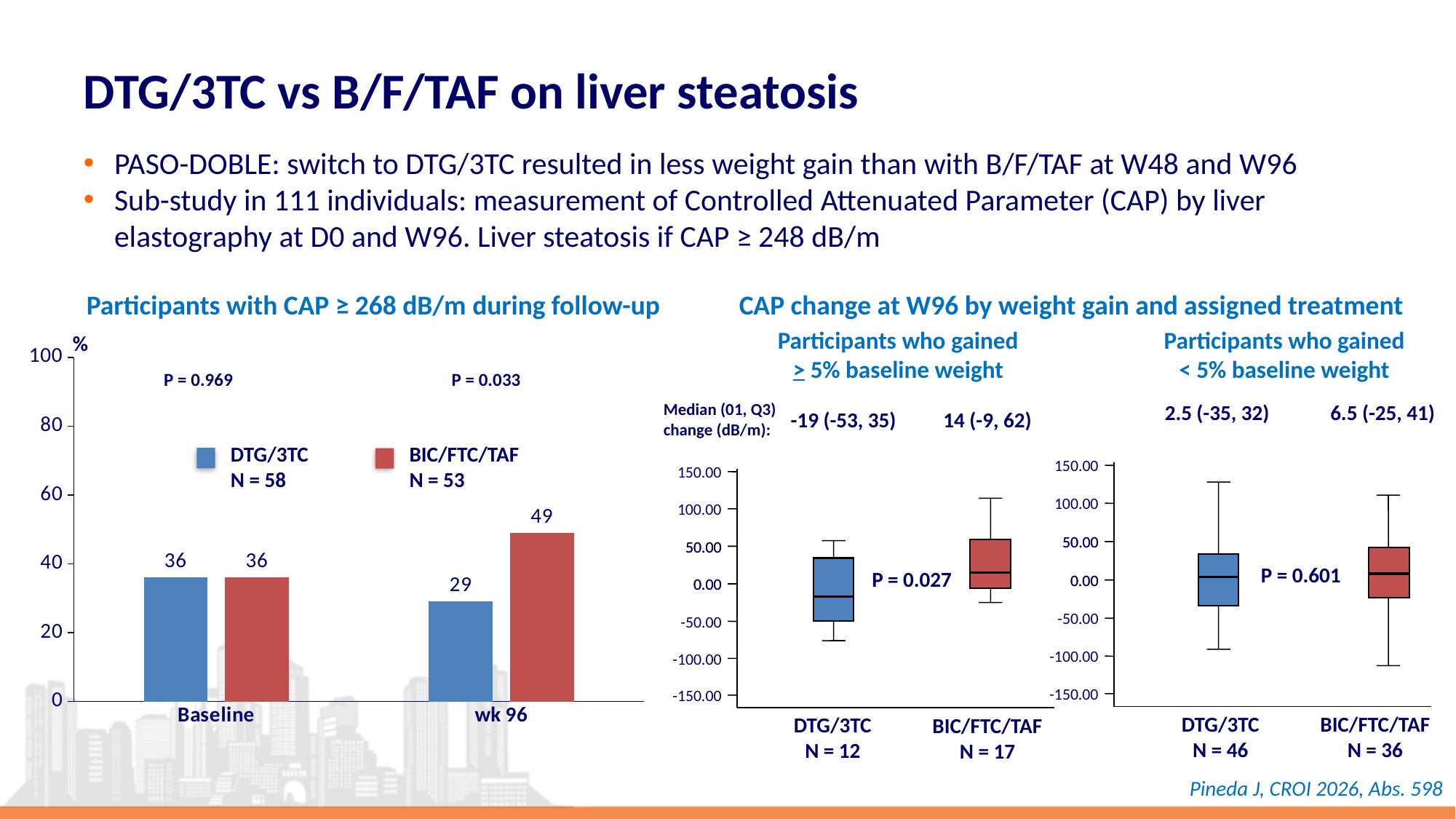
In the bar chart 'Participants with CAP ≥ 268 dB/m during follow-up', what is the value for DTG/3TC at Baseline? 36 In the box plot for participants who gained ≥ 5% baseline weight, what is the median (Q1, Q3) CAP change for DTG/3TC? -19 (-53, 35) In the bar chart 'Participants with CAP ≥ 268 dB/m during follow-up', what is the difference between BIC/FTC/TAF and DTG/3TC at wk 96? 20 In the bar chart 'Participants with CAP ≥ 268 dB/m during follow-up', what P value is shown for wk 96? P = 0.033 In the bar chart 'Participants with CAP ≥ 268 dB/m during follow-up', which bar is the highest? BIC/FTC/TAF at wk 96 In the box plot for participants who gained < 5% baseline weight, what is the median (Q1, Q3) CAP change for BIC/FTC/TAF? 6.5 (-25, 41) In the bar chart 'Participants with CAP ≥ 268 dB/m during follow-up', how many series does the legend list? 2 What type of chart is 'Participants with CAP ≥ 268 dB/m during follow-up'? bar chart In the bar chart 'Participants with CAP ≥ 268 dB/m during follow-up', what is the value for DTG/3TC at wk 96? 29 In the bar chart 'Participants with CAP ≥ 268 dB/m during follow-up', does the DTG/3TC value rise or fall from Baseline to wk 96? fall In the bar chart 'Participants with CAP ≥ 268 dB/m during follow-up', what is the value for BIC/FTC/TAF at wk 96? 49 In the box plot for participants who gained ≥ 5% baseline weight, what is the N for BIC/FTC/TAF? N = 17